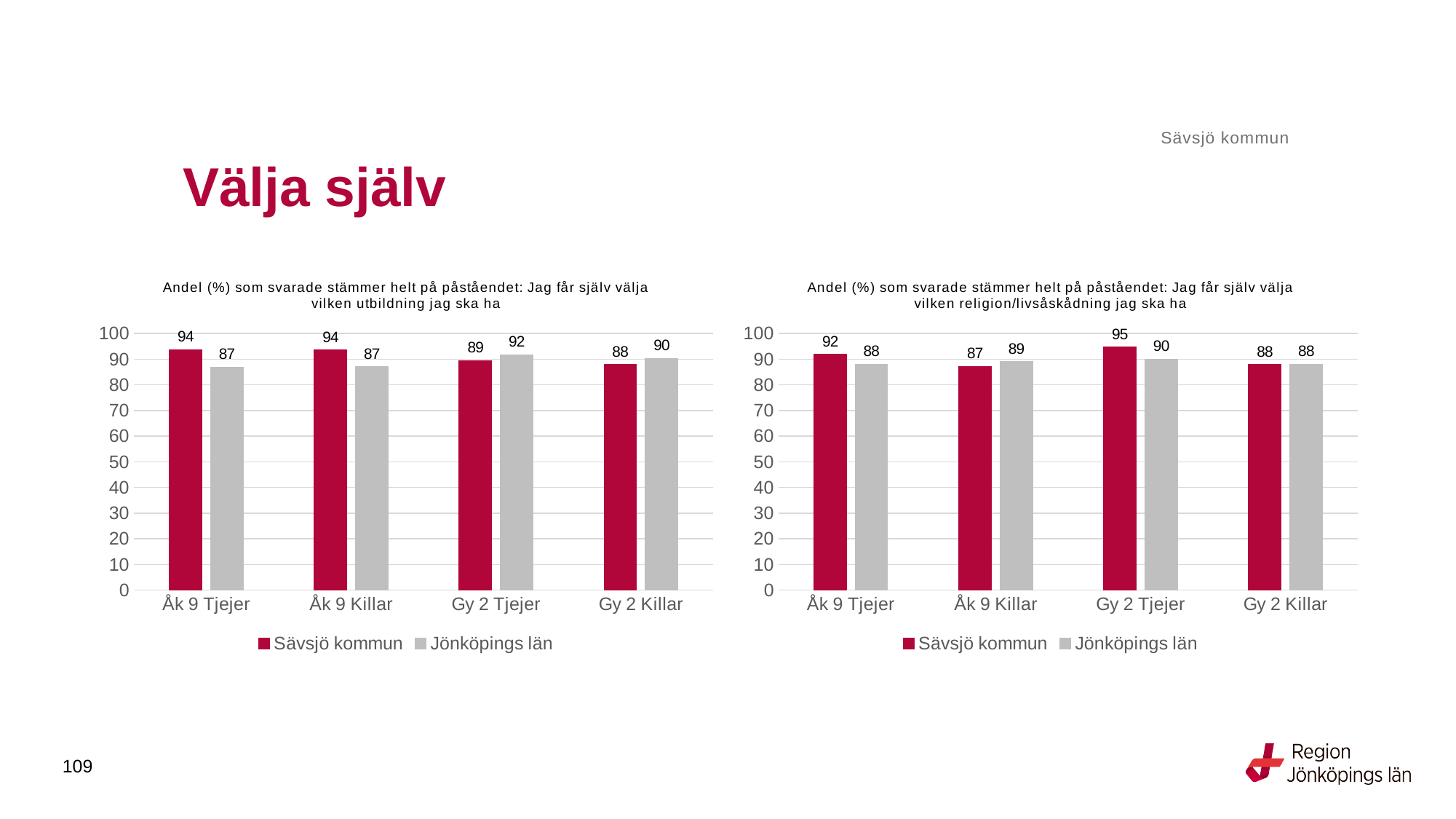
In the right chart (religion/livsåskådning), which category has the lowest value for Sävsjö kommun? Åk 9 Killar In the right chart (religion/livsåskådning), which category has the highest value for Sävsjö kommun? Gy 2 Tjejer What kind of chart is the left chart (utbildning)? Bar chart In the right chart (religion/livsåskådning), what is the difference between Sävsjö kommun and Jönköpings län for Gy 2 Tjejer? 5 In the right chart (religion/livsåskådning), what is the value for Jönköpings län for Åk 9 Killar? 89 In the left chart (utbildning), what is the value for Jönköpings län for Gy 2 Tjejer? 92 How many categories are shown on the x axis of the left chart (utbildning)? 4 In the left chart (utbildning), what is the difference between Sävsjö kommun and Jönköpings län for Åk 9 Killar? 7 How many series does the legend of the right chart (religion/livsåskådning) list? 2 In the right chart (religion/livsåskådning), what is the value for Sävsjö kommun for Gy 2 Tjejer? 95 In the left chart (utbildning), what is the value for Sävsjö kommun for Åk 9 Tjejer? 94 In the left chart (utbildning), which is larger for Gy 2 Killar: Sävsjö kommun or Jönköpings län? Jönköpings län